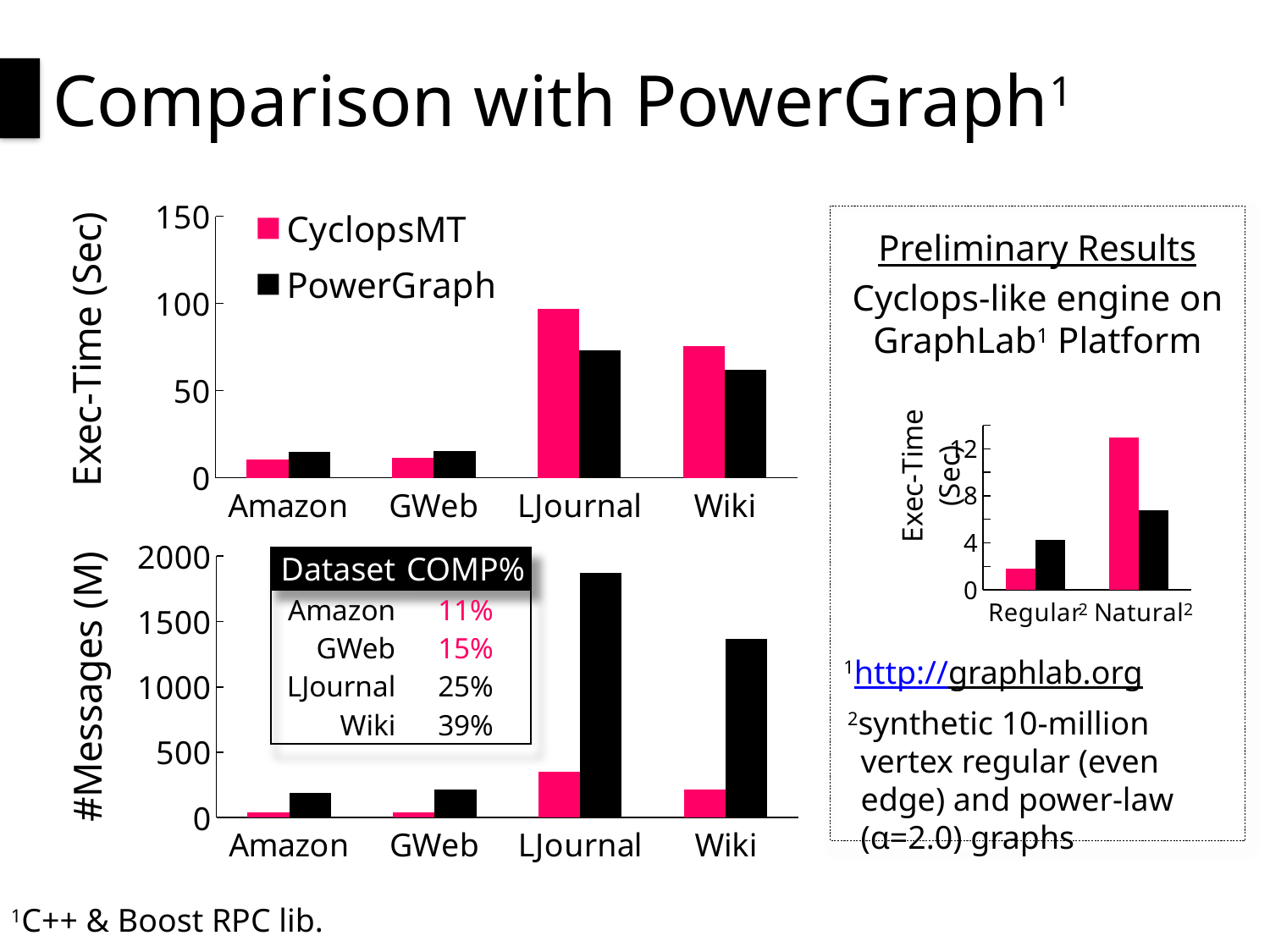
In the Preliminary Results chart on the right, is the pink bar for Natural greater or less than 8? greater In the #Messages (M) chart, which dataset has the highest PowerGraph message count? LJournal In the Exec-Time (Sec) chart, how many datasets are shown on the x axis? 4 In the Preliminary Results chart on the right, how many categories are shown on the x axis? 2 In the #Messages (M) chart, which is larger for Wiki, CyclopsMT or PowerGraph? PowerGraph In the Exec-Time (Sec) chart, which dataset has the highest CyclopsMT execution time? LJournal What kind of chart is the #Messages (M) chart? bar chart In the Exec-Time (Sec) chart, is the PowerGraph value for Amazon greater or less than 50? less In the #Messages (M) chart, is the PowerGraph value for LJournal greater or less than 1500? greater In the Exec-Time (Sec) chart, how many series does the legend list? 2 In the Exec-Time (Sec) chart, which is larger for Wiki, CyclopsMT or PowerGraph? CyclopsMT